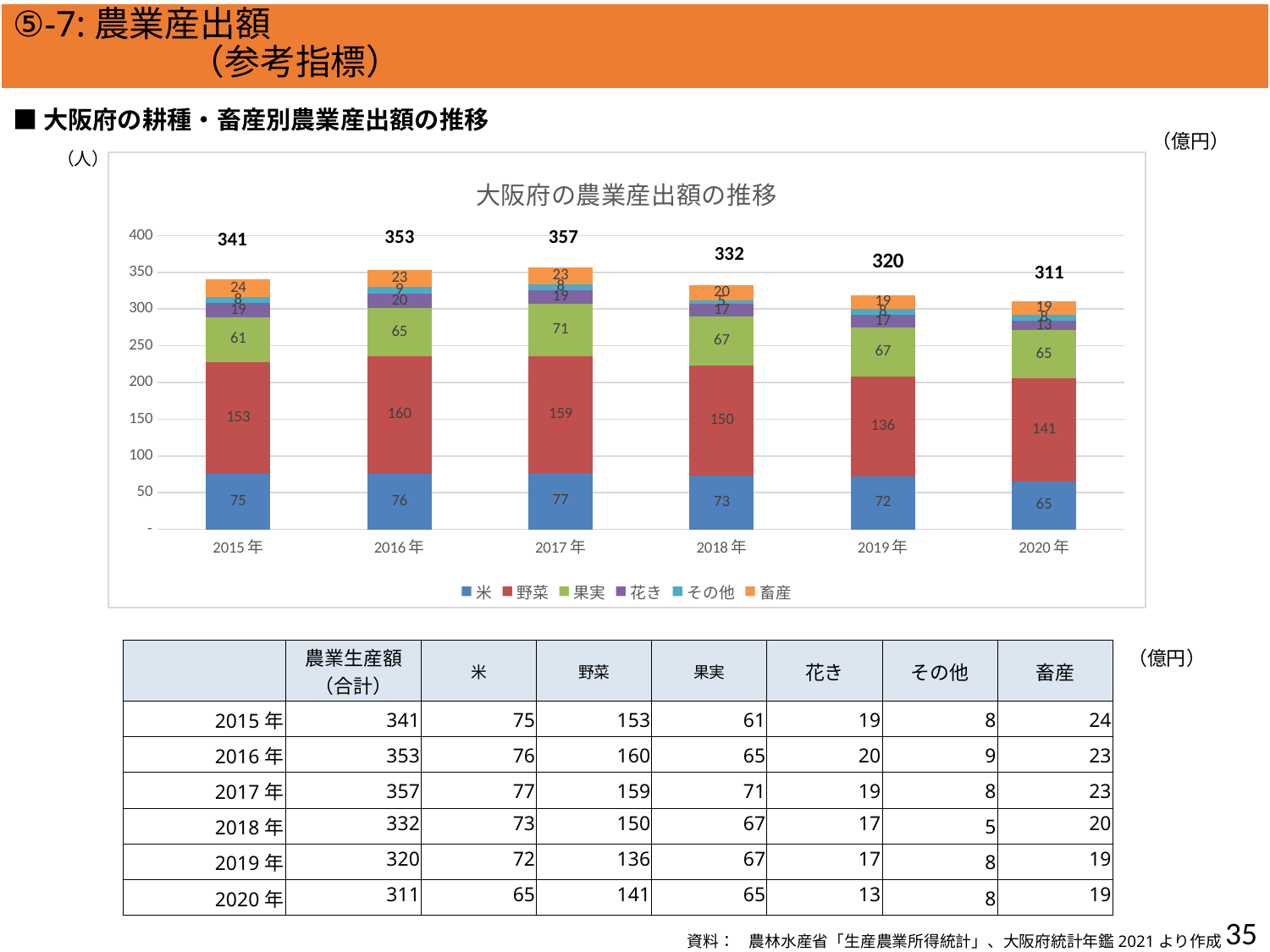
How many series does the chart legend list? 6 How many years are plotted on the x axis of the chart? 6 What is the value of 野菜 for 2016年? 160 Do the total values rise or fall from 2017年 to 2020年? fall Which is larger, the 果実 value for 2017年 or the 果実 value for 2015年? 2017年 What is the value of 米 for 2020年? 65 Which year has the highest total agricultural output? 2017年 What type of chart is shown on the slide? stacked bar chart What is the title of the chart? 大阪府の農業産出額の推移 What is the difference between the total for 2015年 and the total for 2020年? 30 Which year has the lowest total agricultural output? 2020年 What is the total of the stacked bar for 2017年? 357